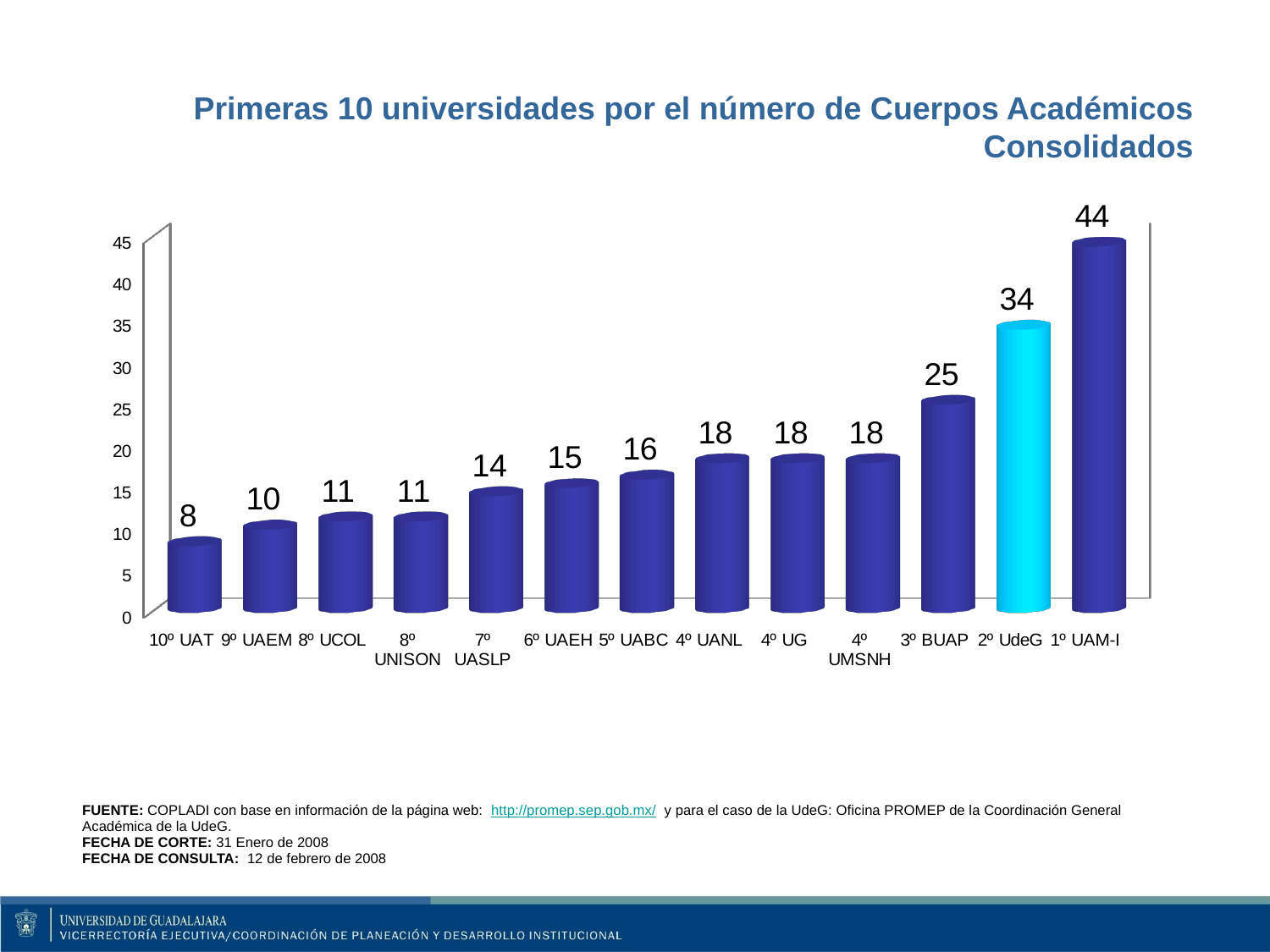
What is the difference between the values for 1º UAM-I and 2º UdeG? 10 Which bar is shown in a different colour (light blue) from the others? 2º UdeG What kind of chart is shown on the slide? bar chart What is the value for 2º UdeG? 34 Do the values rise or fall from left to right along the x axis? rise Which university has the lowest value on the chart? 10º UAT How many bars are shown on the chart? 13 Which is larger, the value for 7º UASLP or the value for 5º UABC? 5º UABC Which university has the highest number of Cuerpos Académicos Consolidados? 1º UAM-I What is the value for 3º BUAP? 25 What is the value for 6º UAEH? 15 What is the value for 10º UAT? 8